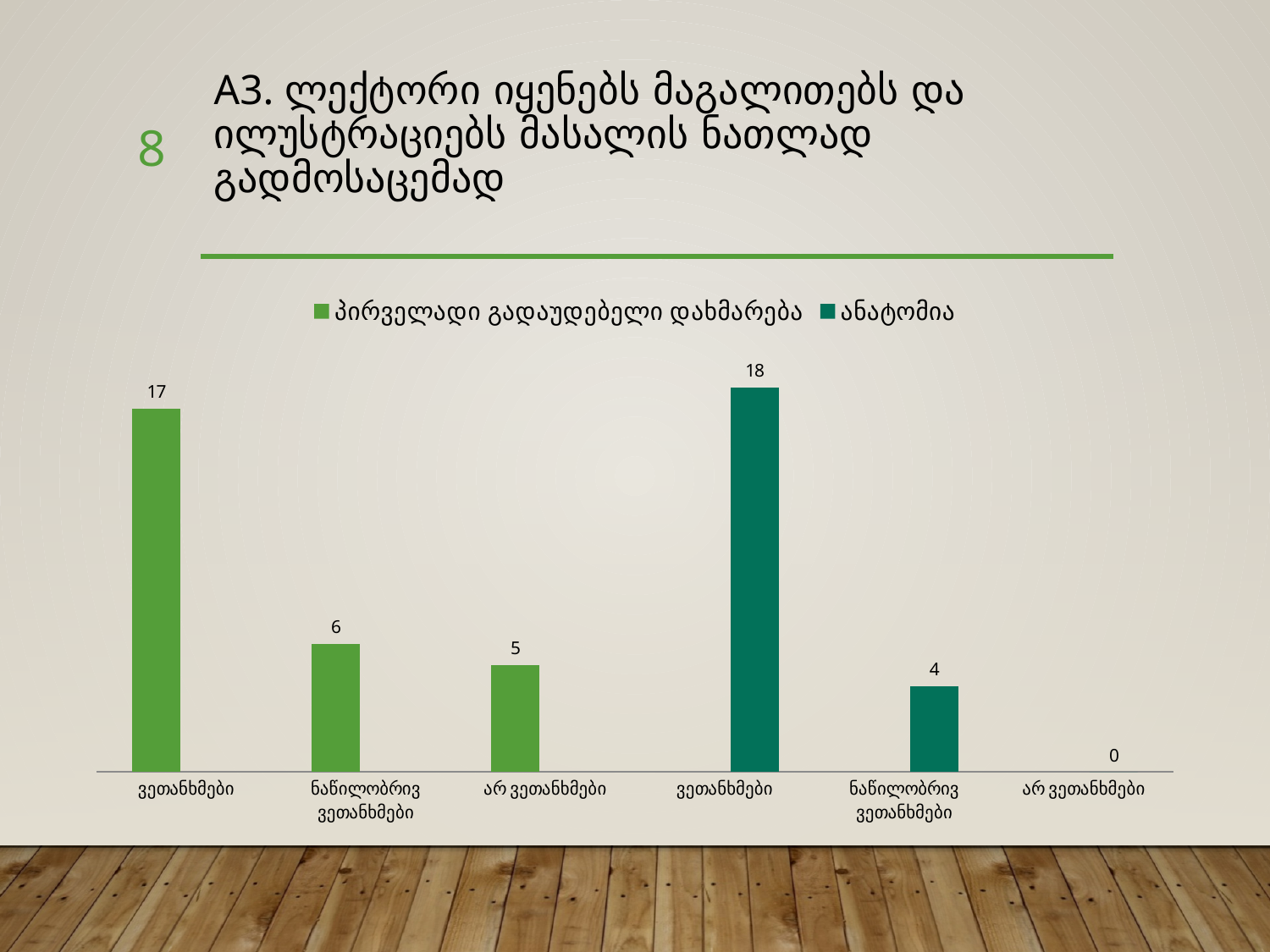
Which bar has the lowest value in the chart? არ ვეთანხმები (ანატომია), 0 What is the value of the 'არ ვეთანხმები' bar for the series 'პირველადი გადაუდებელი დახმარება'? 5 What type of chart is shown on the slide? bar chart Which series is shown in the darker green colour in the legend? ანატომია What is the value of the 'ნაწილობრივ ვეთანხმები' bar for the series 'ანატომია'? 4 How many series does the legend list? 2 Which bar has the highest value in the chart? ვეთანხმები (ანატომია), 18 Which is larger: the 'ვეთანხმები' value for 'პირველადი გადაუდებელი დახმარება' or for 'ანატომია'? ანატომია What is the difference between the 'ნაწილობრივ ვეთანხმები' values for 'პირველადი გადაუდებელი დახმარება' and 'ანატომია'? 2 What is the value of the 'ვეთანხმები' bar for the series 'ანატომია'? 18 What is the value of the 'ვეთანხმები' bar for the series 'პირველადი გადაუდებელი დახმარება'? 17 How many bars are plotted in the chart? 6